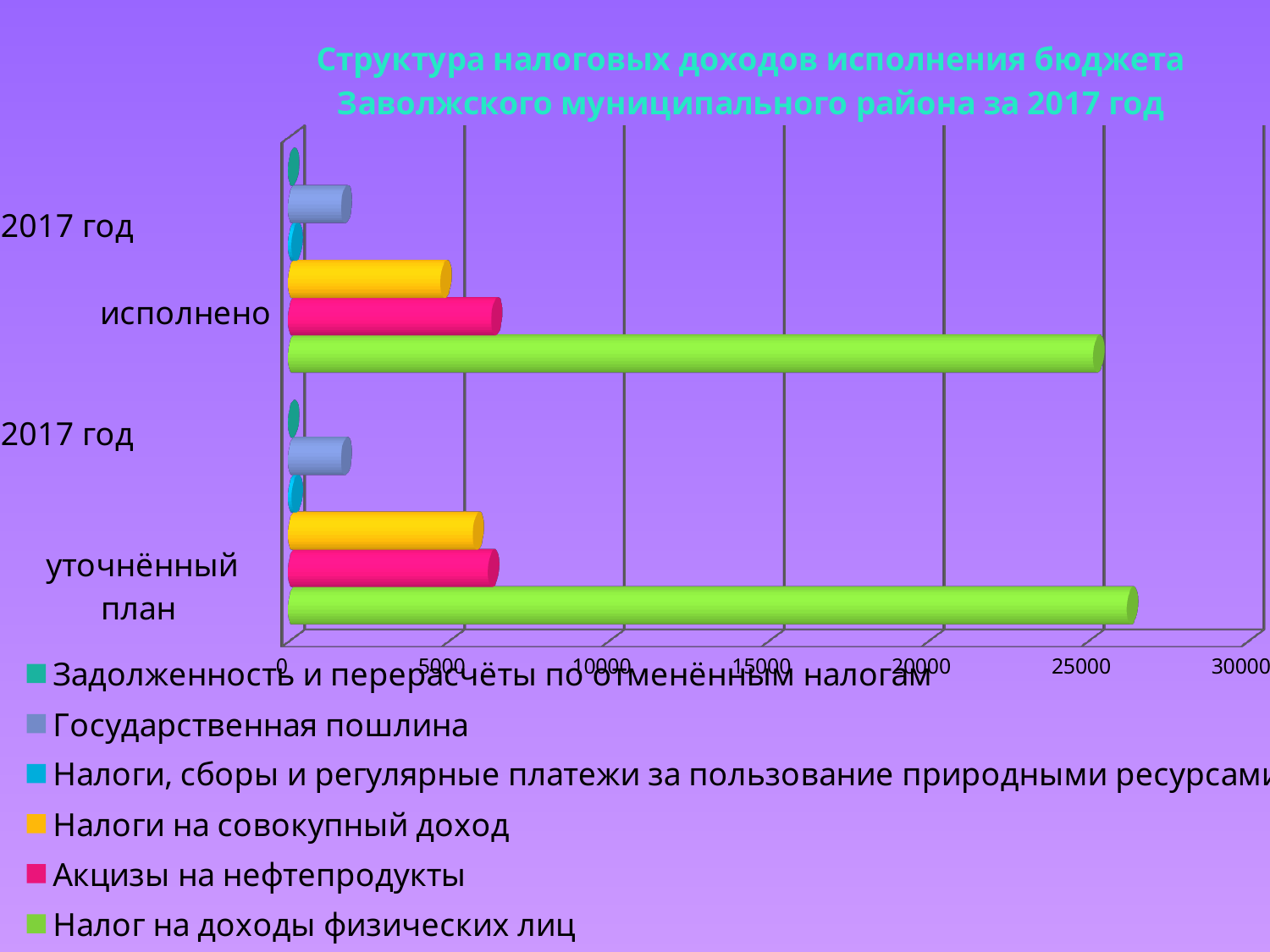
Is the value of "Акцизы на нефтепродукты" for "2017 год исполнено" greater or less than 5000? greater How many categories are shown on the vertical axis? 2 Which series has the highest value for "2017 год исполнено"? Налог на доходы физических лиц Which series has the highest value for "2017 год уточнённый план"? Налог на доходы физических лиц What is the title of the chart? Структура налоговых доходов исполнения бюджета Заволжского муниципального района за 2017 год Is the value of "Налог на доходы физических лиц" for "2017 год уточнённый план" greater or less than 25000? greater Is the value of "Государственная пошлина" for "2017 год уточнённый план" greater or less than 5000? less For "2017 год исполнено", which is larger: "Акцизы на нефтепродукты" or "Налоги на совокупный доход"? Акцизы на нефтепродукты What kind of chart is shown on the slide? bar chart Is the value of "Налог на доходы физических лиц" larger for "2017 год уточнённый план" or for "2017 год исполнено"? 2017 год уточнённый план How many series does the legend list? 6